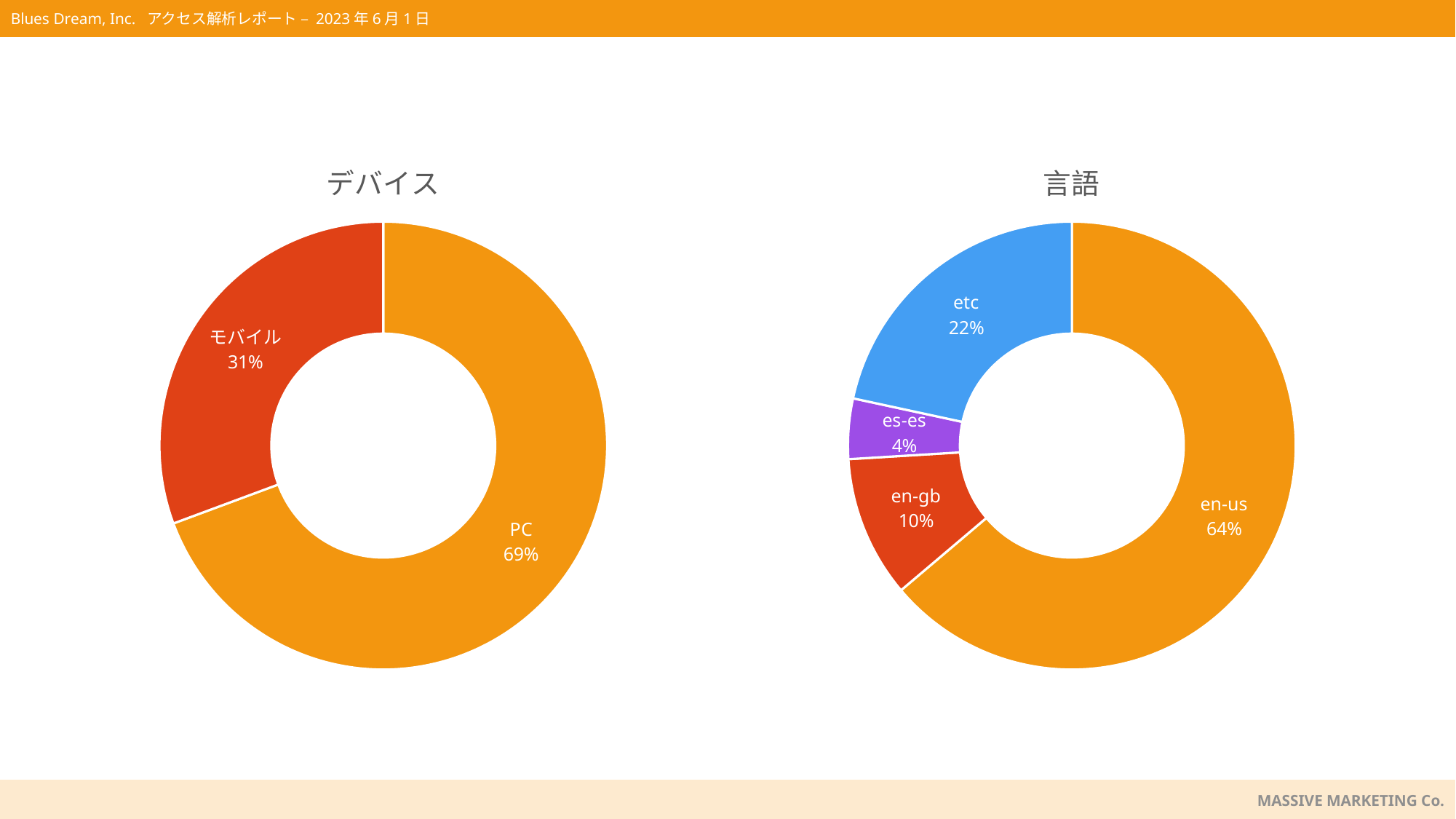
In the 言語 chart, which category has the smallest share? es-es In the デバイス chart, what share does モバイル have? 31% In the 言語 chart, which is larger, etc or en-gb? etc In the 言語 chart, how many categories are shown? 4 In the 言語 chart, what is the difference in percentage points between en-us and etc? 42 In the 言語 chart, what share does en-gb have? 10% In the 言語 chart, what share does en-us have? 64% In the デバイス chart, which category has the largest share? PC In the 言語 chart, what share does es-es have? 4% In the デバイス chart, what share does PC have? 69% In the デバイス chart, what is the difference in percentage points between PC and モバイル? 38 What kind of chart is the 言語 chart? Doughnut chart